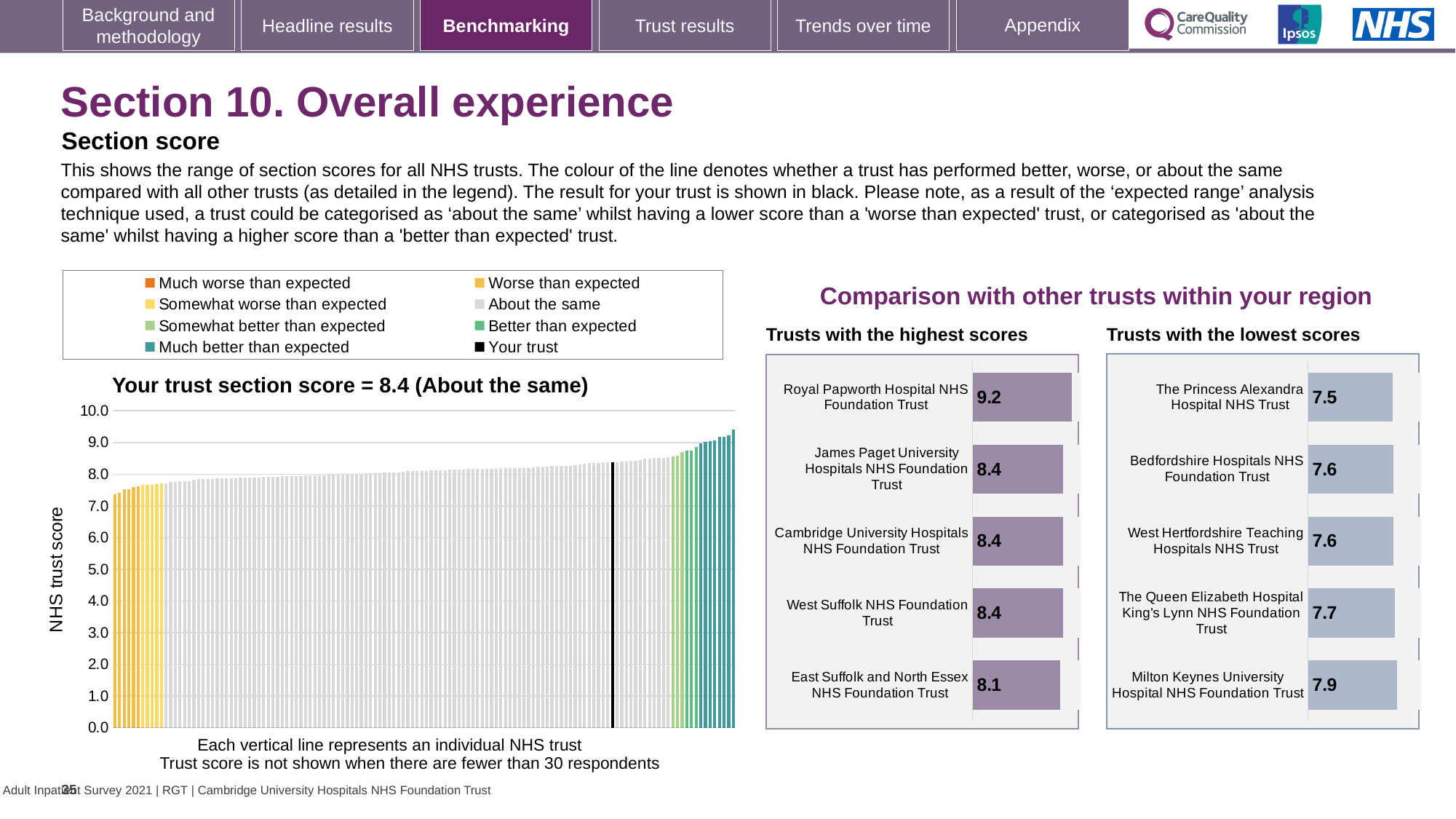
In the 'Trusts with the lowest scores' chart, what is the score for The Princess Alexandra Hospital NHS Trust? 7.5 In the 'Trusts with the highest scores' chart, which trust has the highest score? Royal Papworth Hospital NHS Foundation Trust How many entries does the legend above the 'Your trust section score' chart list? 8 In the 'Trusts with the highest scores' chart, what is the difference between the scores of Royal Papworth Hospital NHS Foundation Trust and East Suffolk and North Essex NHS Foundation Trust? 1.1 In the 'Trusts with the highest scores' chart, what is the score for Royal Papworth Hospital NHS Foundation Trust? 9.2 In the 'Trusts with the lowest scores' chart, what is the score for Milton Keynes University Hospital NHS Foundation Trust? 7.9 In the 'Your trust section score' chart, what is the section score for your trust? 8.4 In the 'Trusts with the lowest scores' chart, which trust has the lowest score? The Princess Alexandra Hospital NHS Trust What kind of chart is the 'Your trust section score' chart on the left? Bar chart How many trusts are shown in the 'Trusts with the highest scores' chart? 5 In the 'Trusts with the lowest scores' chart, what is the difference between the scores of Milton Keynes University Hospital NHS Foundation Trust and The Princess Alexandra Hospital NHS Trust? 0.4 In the 'Trusts with the lowest scores' chart, which has the larger score: Milton Keynes University Hospital NHS Foundation Trust or Bedfordshire Hospitals NHS Foundation Trust? Milton Keynes University Hospital NHS Foundation Trust